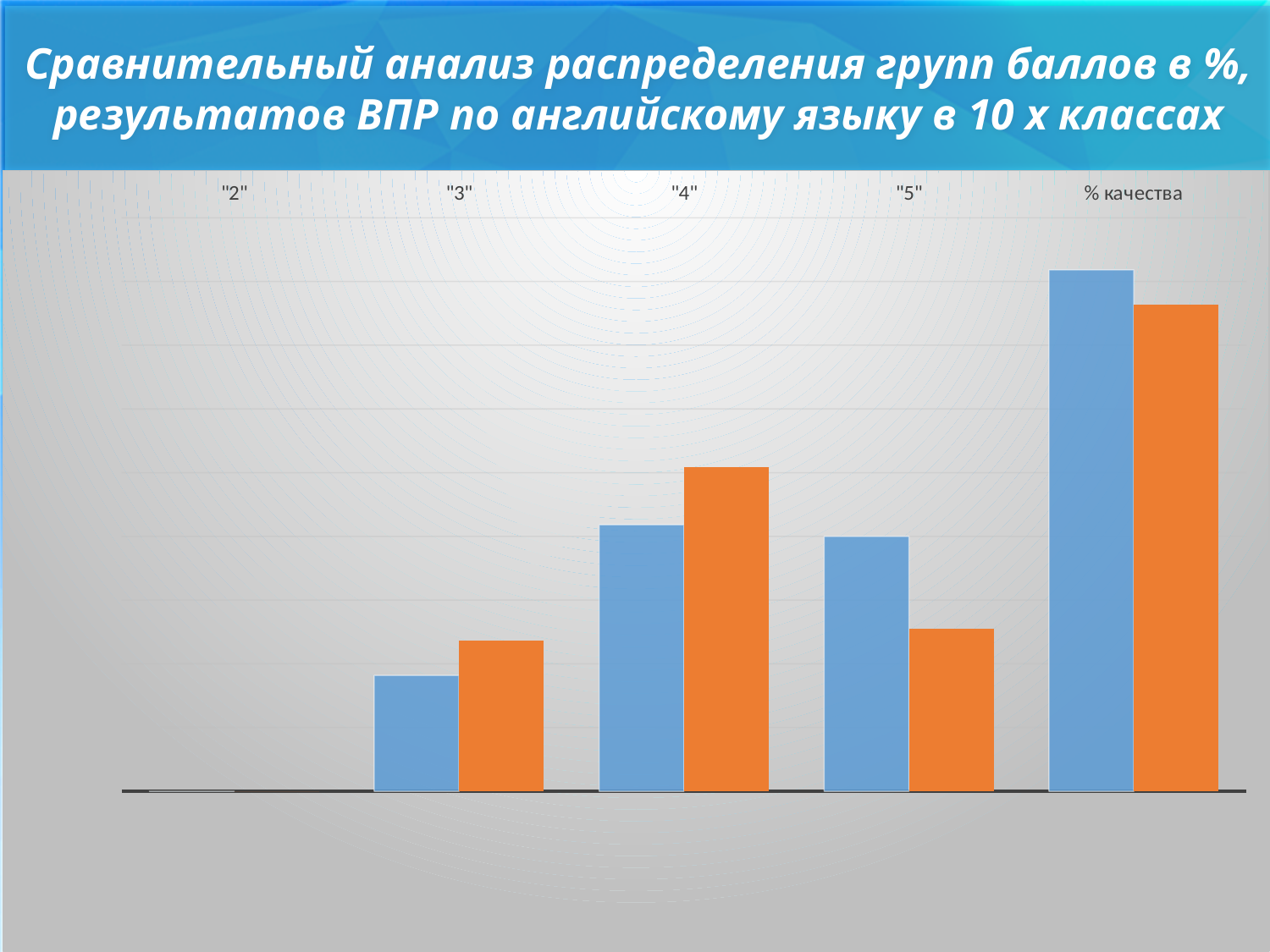
Which category has the tallest orange bar? % качества Which category has the lowest blue bar? "2" For the category "4", which bar is taller, the blue one or the orange one? orange Do the orange bars rise or fall from category "2" to category "4"? rise For the category "3", which bar is taller, the blue one or the orange one? orange Which category has the lowest orange bar? "2" How many categories are shown along the x axis of the chart? 5 What is the label of the last category on the x axis of the chart? % качества For the category "5", which bar is taller, the blue one or the orange one? blue Which category has the tallest blue bar? % качества What kind of chart is shown on the slide? bar chart